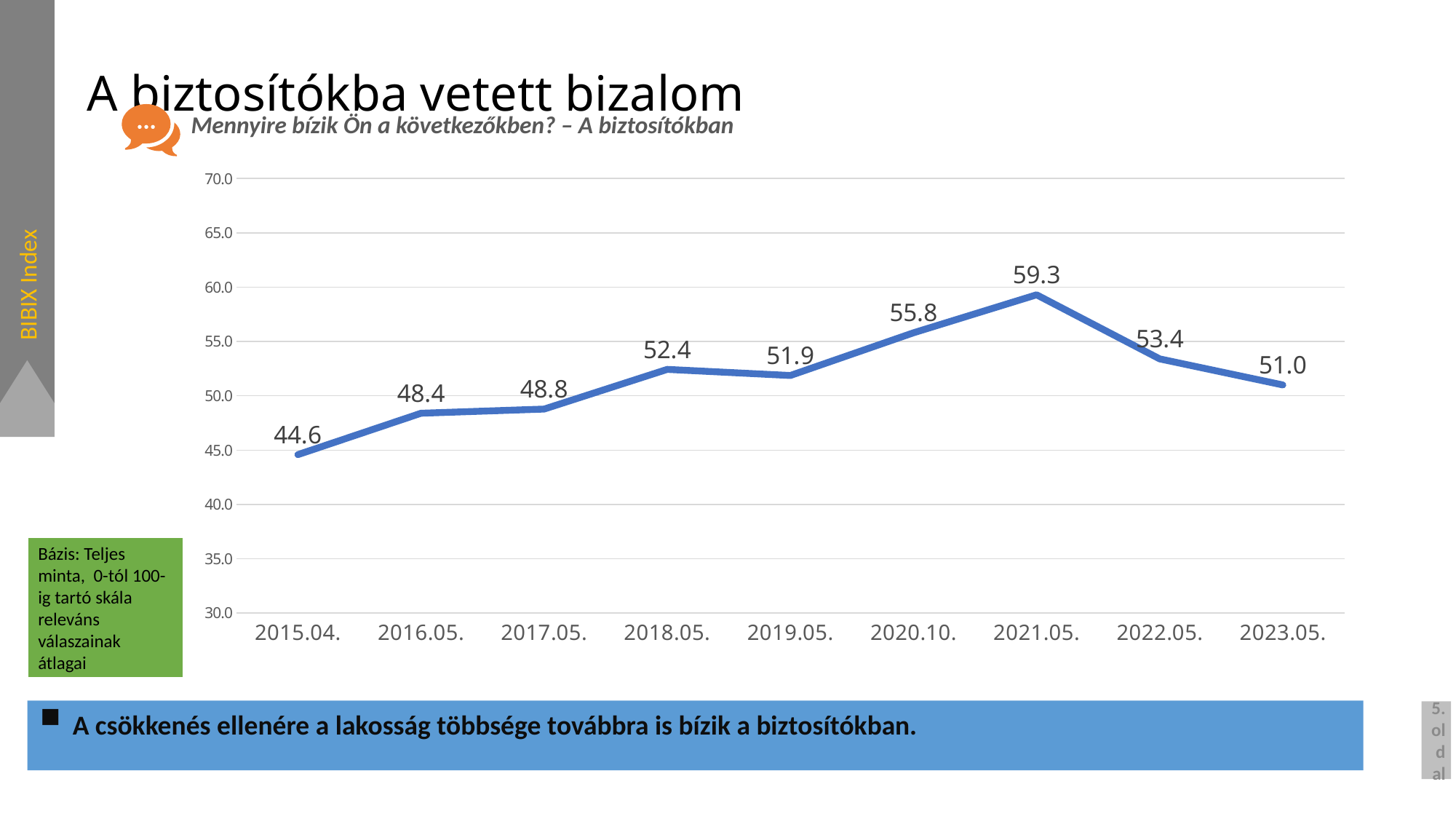
What is the difference between the values for 2021.05. and 2023.05.? 8.3 What is the difference between the values for 2016.05. and 2017.05.? 0.4 What is the value for 2015.04.? 44.6 Do the values rise or fall from 2021.05. to 2023.05.? fall Which year has the highest value? 2021.05. How many data points are plotted on the chart? 9 Which is larger, the value for 2018.05. or the value for 2019.05.? 2018.05. What is the value for 2023.05.? 51.0 Which year has the lowest value? 2015.04. What kind of chart is shown on the slide? line chart What is the value for 2021.05.? 59.3 Is the value for 2020.10. greater or less than 55.0? greater